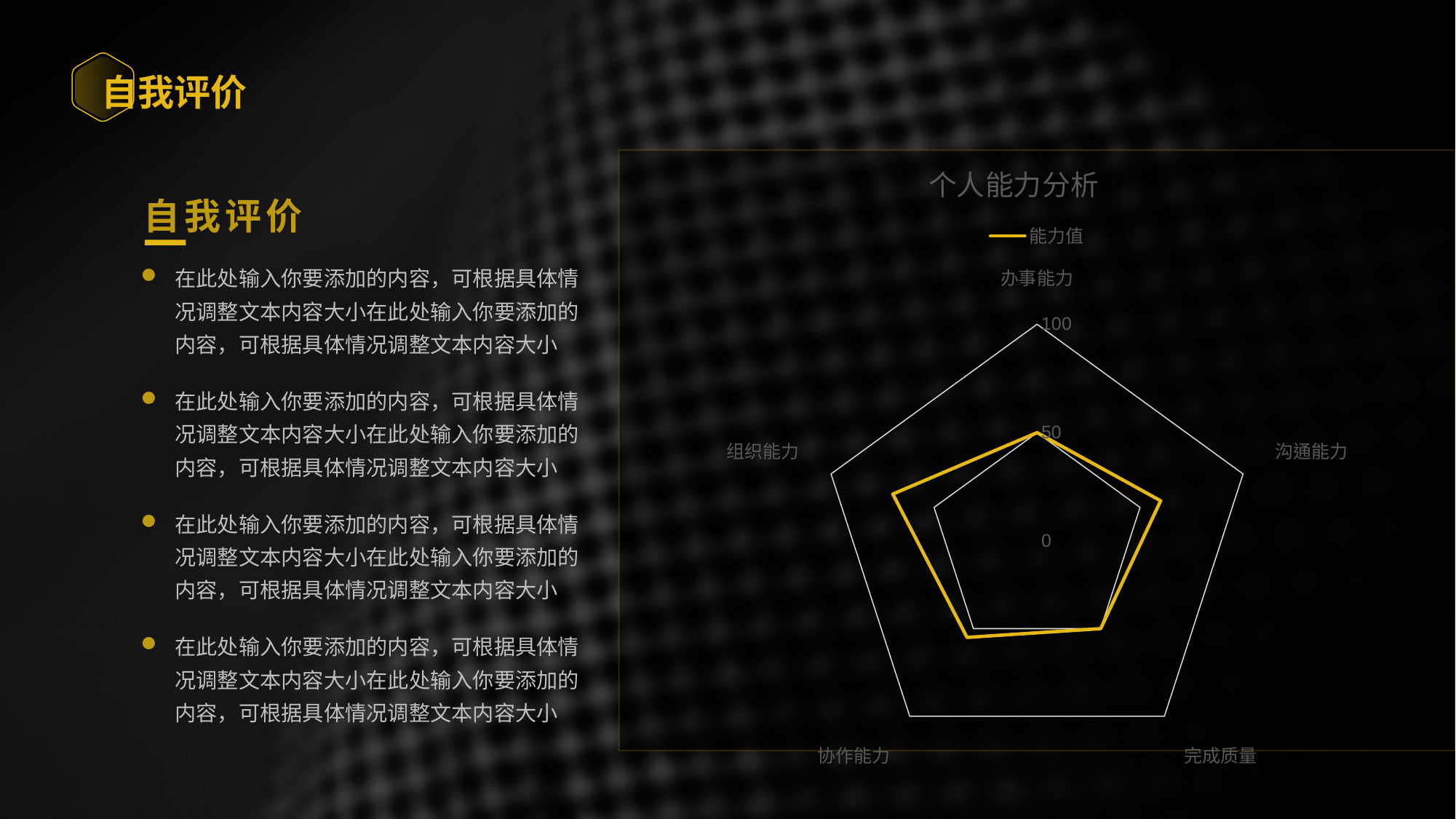
Is the value for 组织能力 greater or less than 50? greater Is the value for 沟通能力 greater or less than 100? less Is the value for 沟通能力 greater or less than 50? greater How many categories (axes) does the radar chart have? 5 What is the name of the series shown in the legend? 能力值 What is the value for 办事能力? 50 How many series does the chart legend list? 1 What kind of chart is shown on the slide? radar chart What is the maximum value shown on the chart's axis scale? 100 What is the title of the chart? 个人能力分析